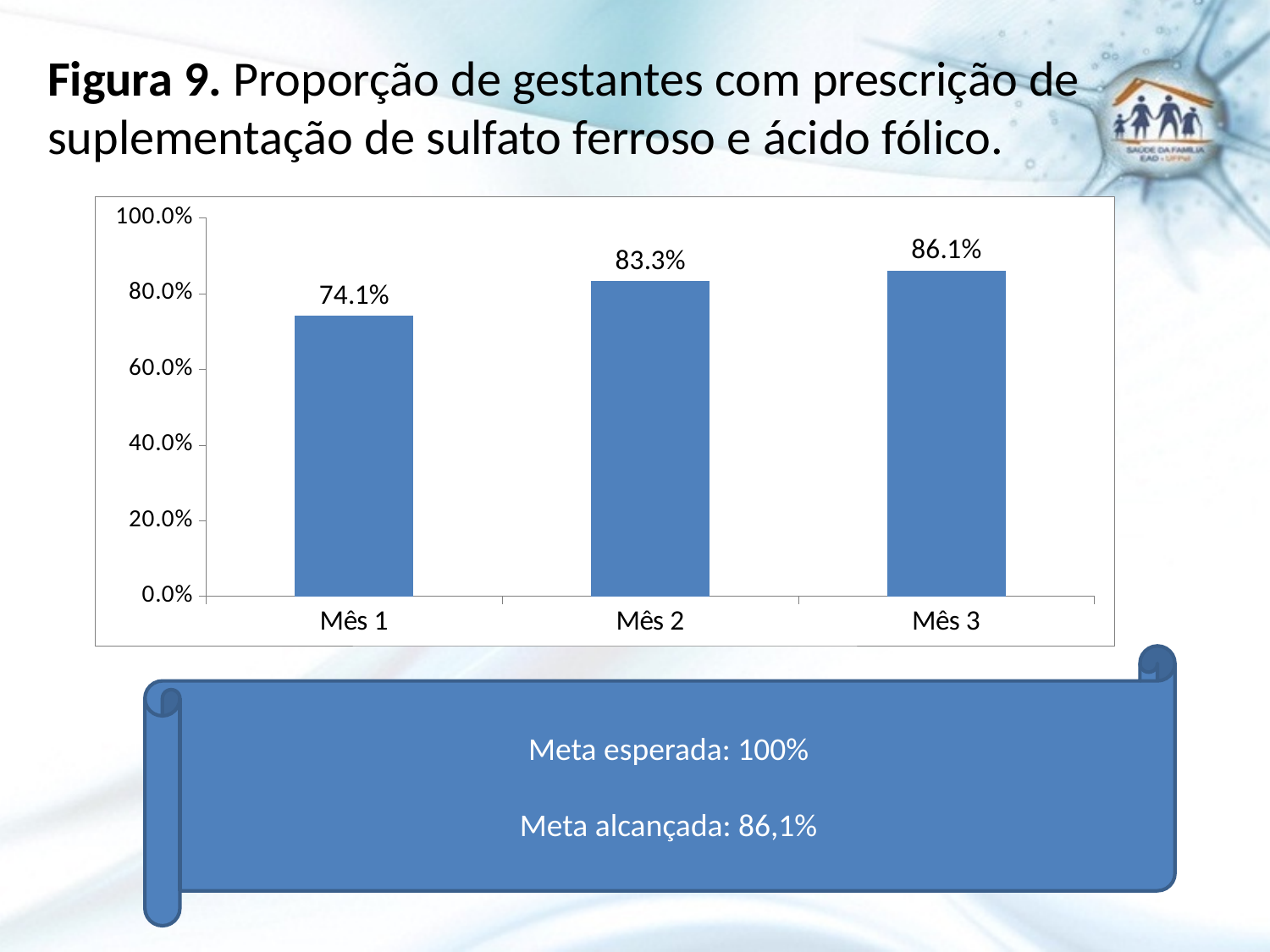
Which month has the lowest value? Mês 1 What is the value for Mês 1? 74.1% What is the value for Mês 2? 83.3% What is the difference between the values for Mês 2 and Mês 1? 9.2% Which is larger, the value for Mês 2 or the value for Mês 3? Mês 3 Is the value for Mês 1 greater or less than 80.0%? less What is the value for Mês 3? 86.1% Do the values rise or fall from Mês 1 to Mês 3? rise Which month has the highest value? Mês 3 What kind of chart is shown on the slide? bar chart How many months are shown on the x axis? 3 What is the difference between the values for Mês 3 and Mês 1? 12.0%